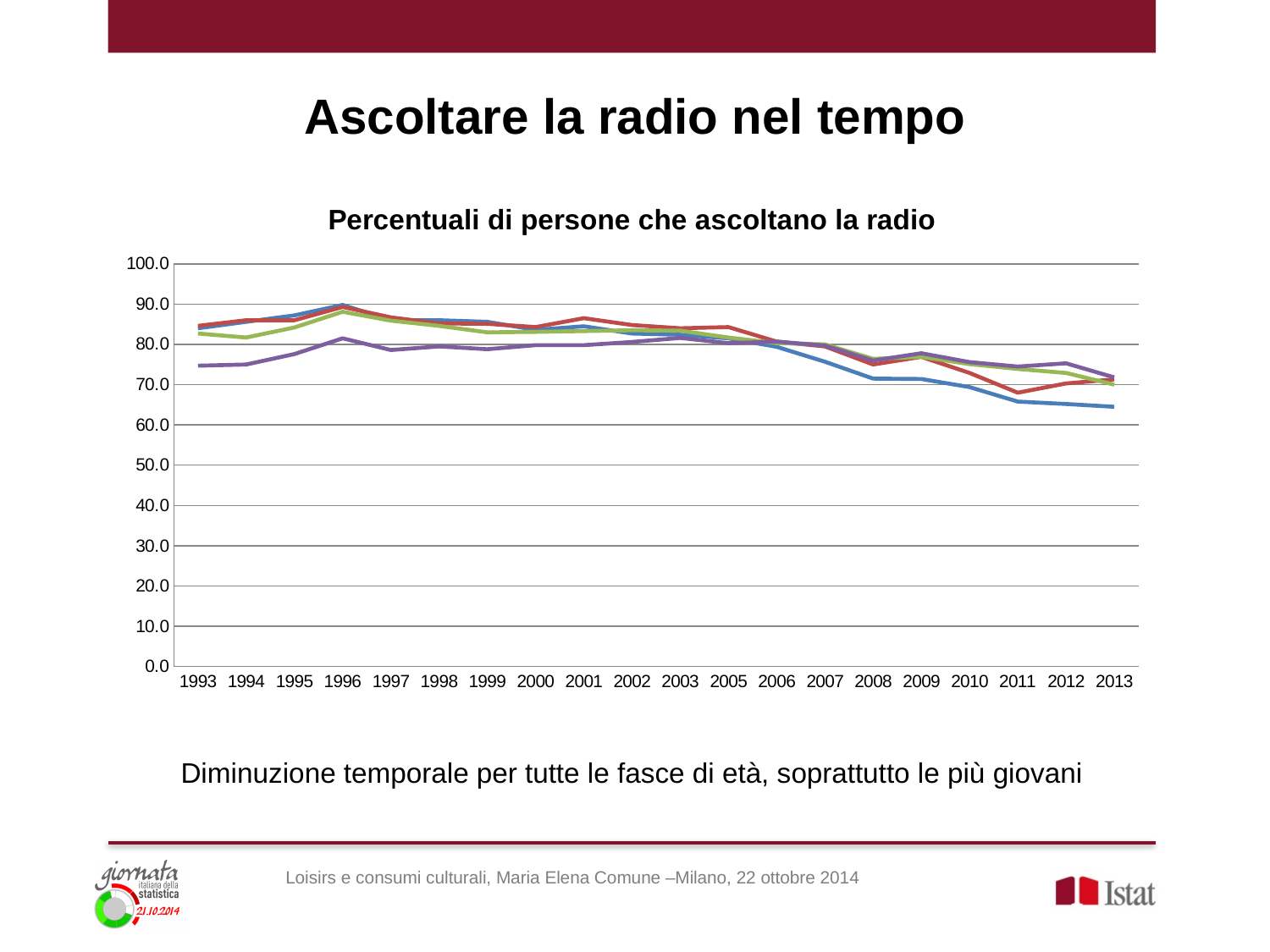
What kind of chart is shown on the slide? line chart In 2013, which line is higher, the blue line or the purple line? purple line In 1993, which line is higher, the blue line or the purple line? blue line Is the value of the red line in 2011 greater or less than 70.0? less In which year does the blue line reach its highest value? 1996 Overall, do the lines rise or fall from 1993 to 2013? fall Is the value of the blue line in 1996 greater or less than 80.0? greater What is the title of the chart? Percentuali di persone che ascoltano la radio Is the value of the blue line in 2013 greater or less than 70.0? less How many lines are plotted on the chart? 4 How many years are shown on the x axis of the chart? 20